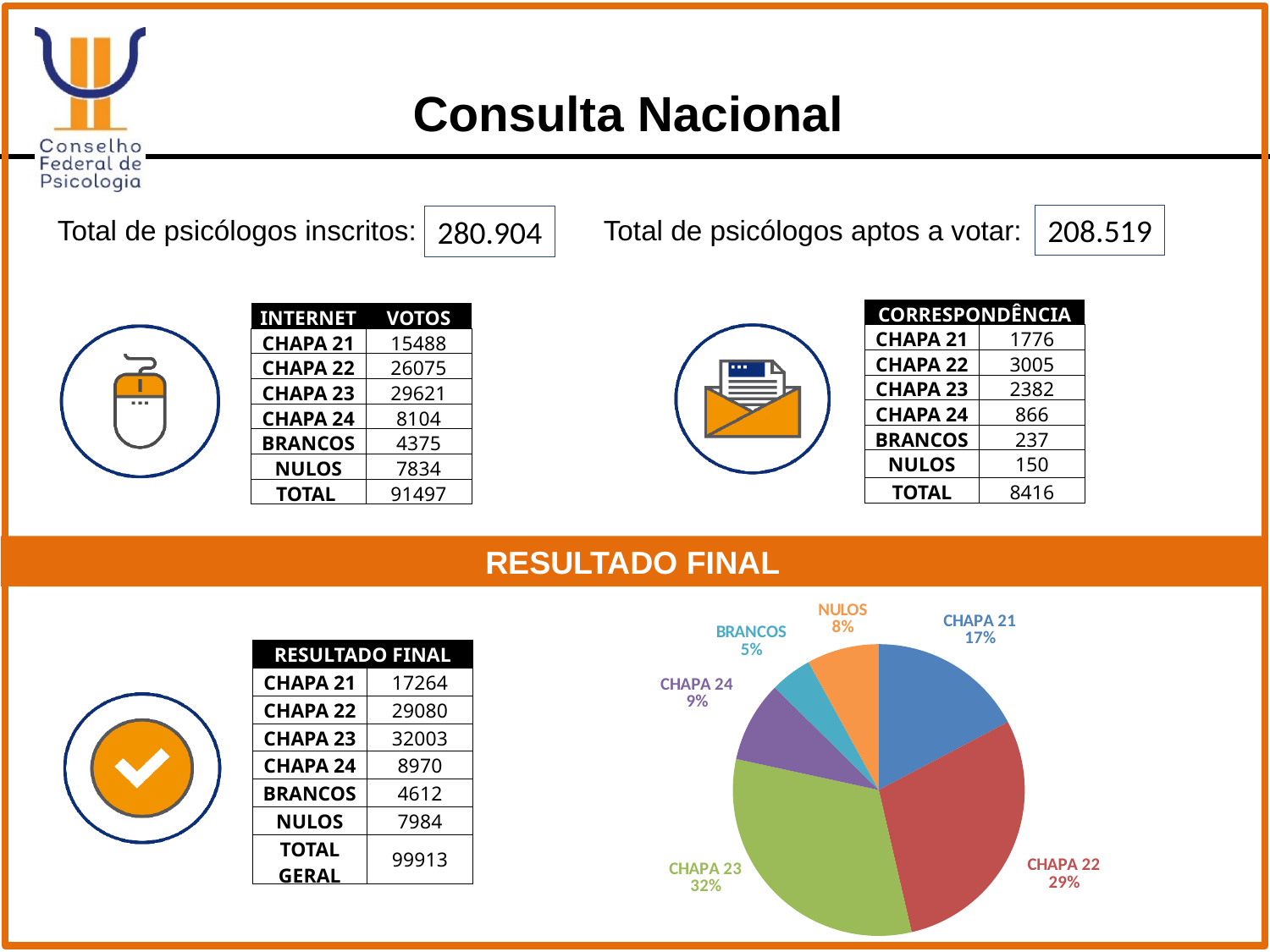
Which slice of the pie chart is the largest? CHAPA 23 Which slice of the pie chart is the smallest? BRANCOS What share of the pie chart does CHAPA 23 hold? 32% What kind of chart is shown on the slide? pie chart What percentage is shown for CHAPA 21 in the pie chart? 17% What percentage is shown for CHAPA 24 in the pie chart? 9% What colour is the CHAPA 23 slice in the pie chart? green What is the difference in percentage points between CHAPA 23 and CHAPA 22 in the pie chart? 3% What percentage is shown for NULOS in the pie chart? 8% In the pie chart, which is larger: CHAPA 22 or CHAPA 21? CHAPA 22 What percentage is shown for CHAPA 22 in the pie chart? 29% How many slices does the pie chart have? 6